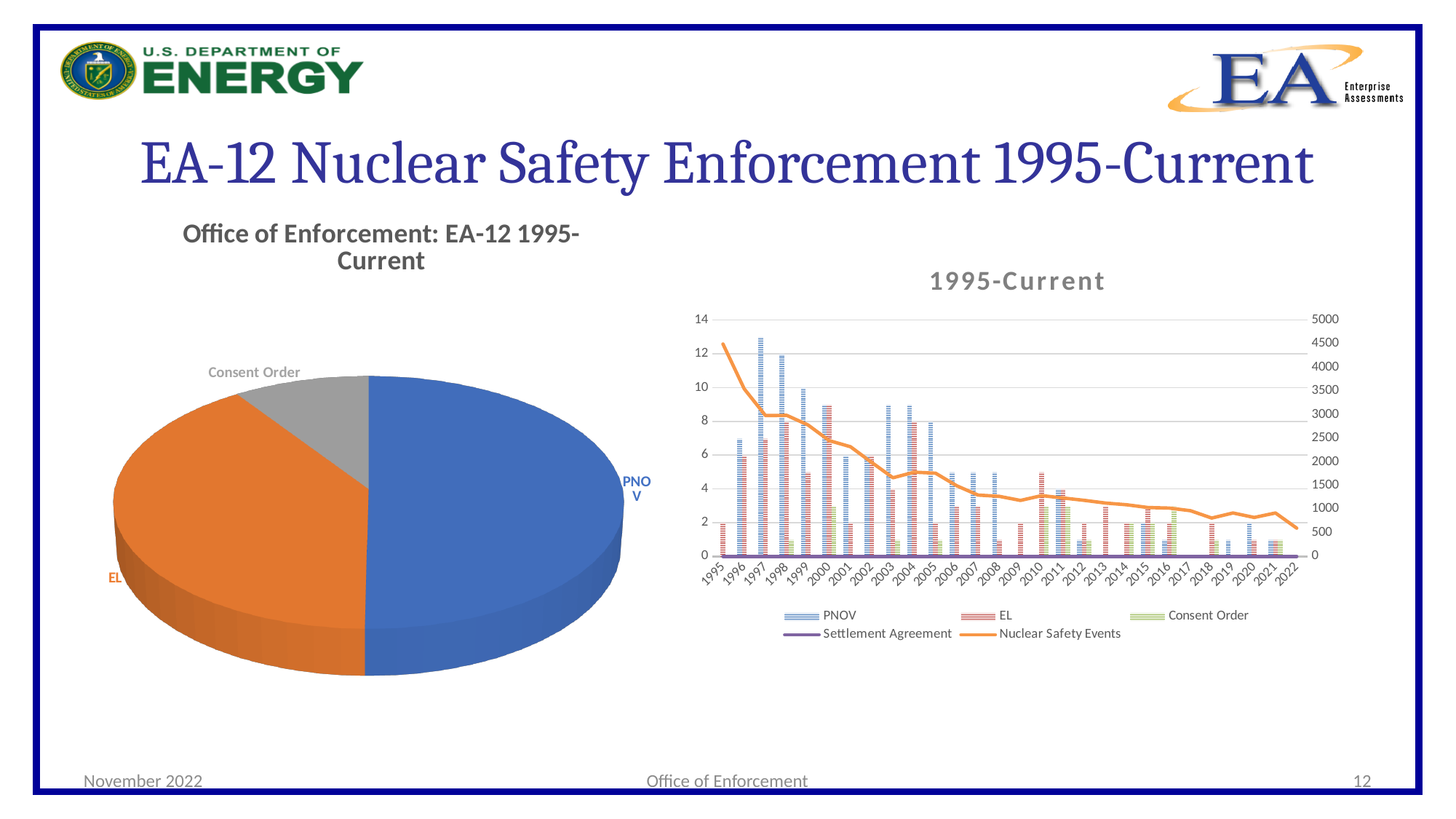
In the right chart titled '1995-Current', is the Nuclear Safety Events value for 1995 greater or less than 4000? greater In the right chart titled '1995-Current', how many years are shown on the x axis? 28 In the left pie chart, which category has the largest slice? PNOV What kind of chart is the left chart titled 'Office of Enforcement: EA-12 1995-Current'? pie chart In the right chart titled '1995-Current', does the Nuclear Safety Events line generally rise or fall from 1995 to 2022? fall In the left pie chart, how many slices are shown? 3 In the right chart titled '1995-Current', in which year is the PNOV bar highest? 1997 In the right chart titled '1995-Current', is the PNOV value for 1997 greater or less than 12? greater In the right chart titled '1995-Current', is the Nuclear Safety Events value for 2022 greater or less than 1000? less In the right chart titled '1995-Current', how many series does the legend list? 5 In the left pie chart, which category has the smallest slice? Consent Order In the left pie chart, which slice is larger, EL or Consent Order? EL